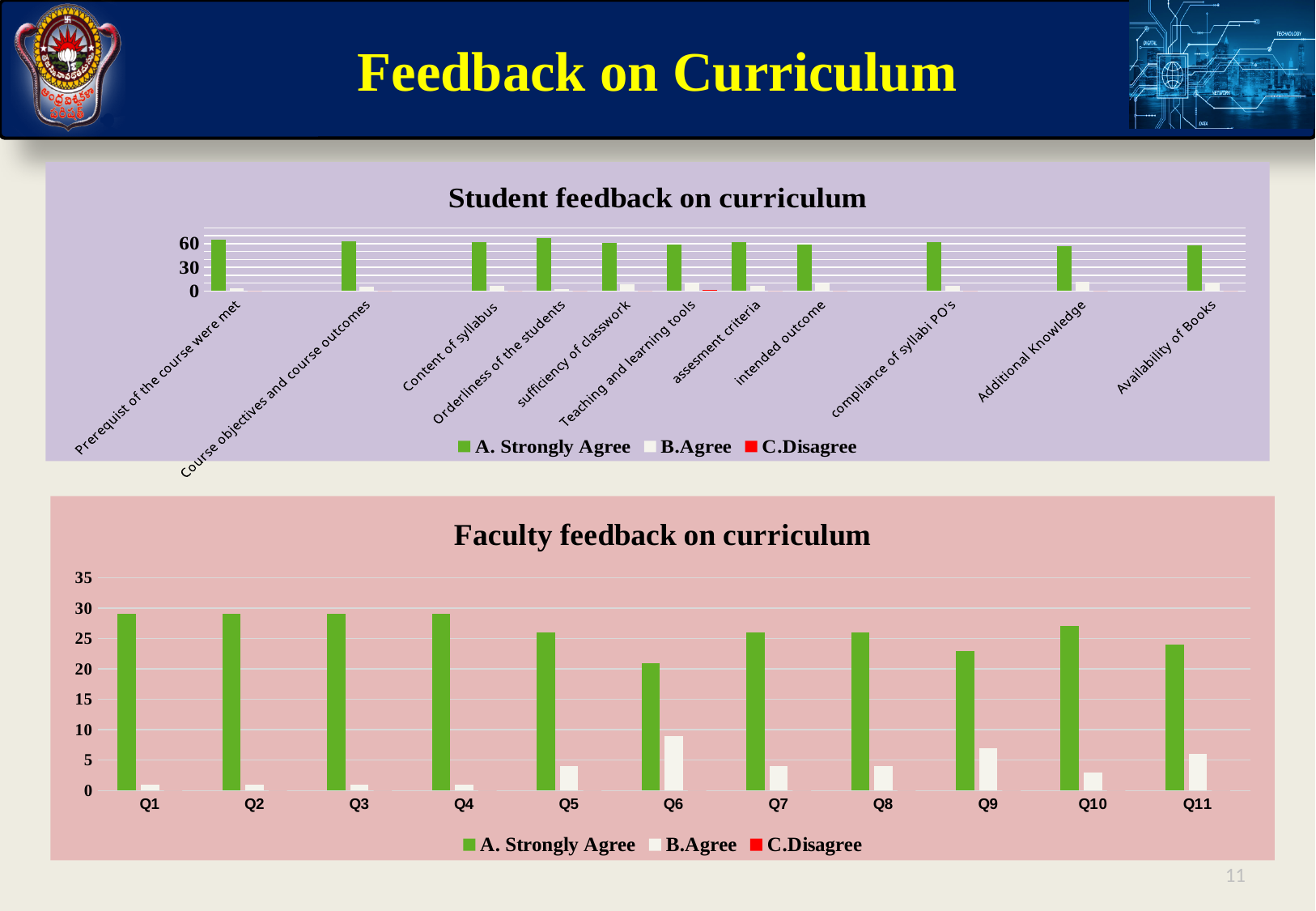
In the Faculty feedback on curriculum chart, is the A. Strongly Agree value for Q6 greater or less than 25? less What kind of chart is the Student feedback on curriculum chart? Bar chart In the Faculty feedback on curriculum chart, which question has the lowest A. Strongly Agree value? Q6 How many series does the legend of the Student feedback on curriculum chart list? 3 How many questions are shown on the x axis of the Faculty feedback on curriculum chart? 11 In the Faculty feedback on curriculum chart, is the B.Agree value for Q1 greater or less than 5? less In the Student feedback on curriculum chart, which category shows a visible C.Disagree bar? Teaching and learning tools In the Student feedback on curriculum chart, is the A. Strongly Agree value for Content of syllabus greater or less than 30? greater In the Faculty feedback on curriculum chart, which is larger, the A. Strongly Agree value for Q1 or for Q6? Q1 In the Faculty feedback on curriculum chart, which question has the highest B.Agree value? Q6